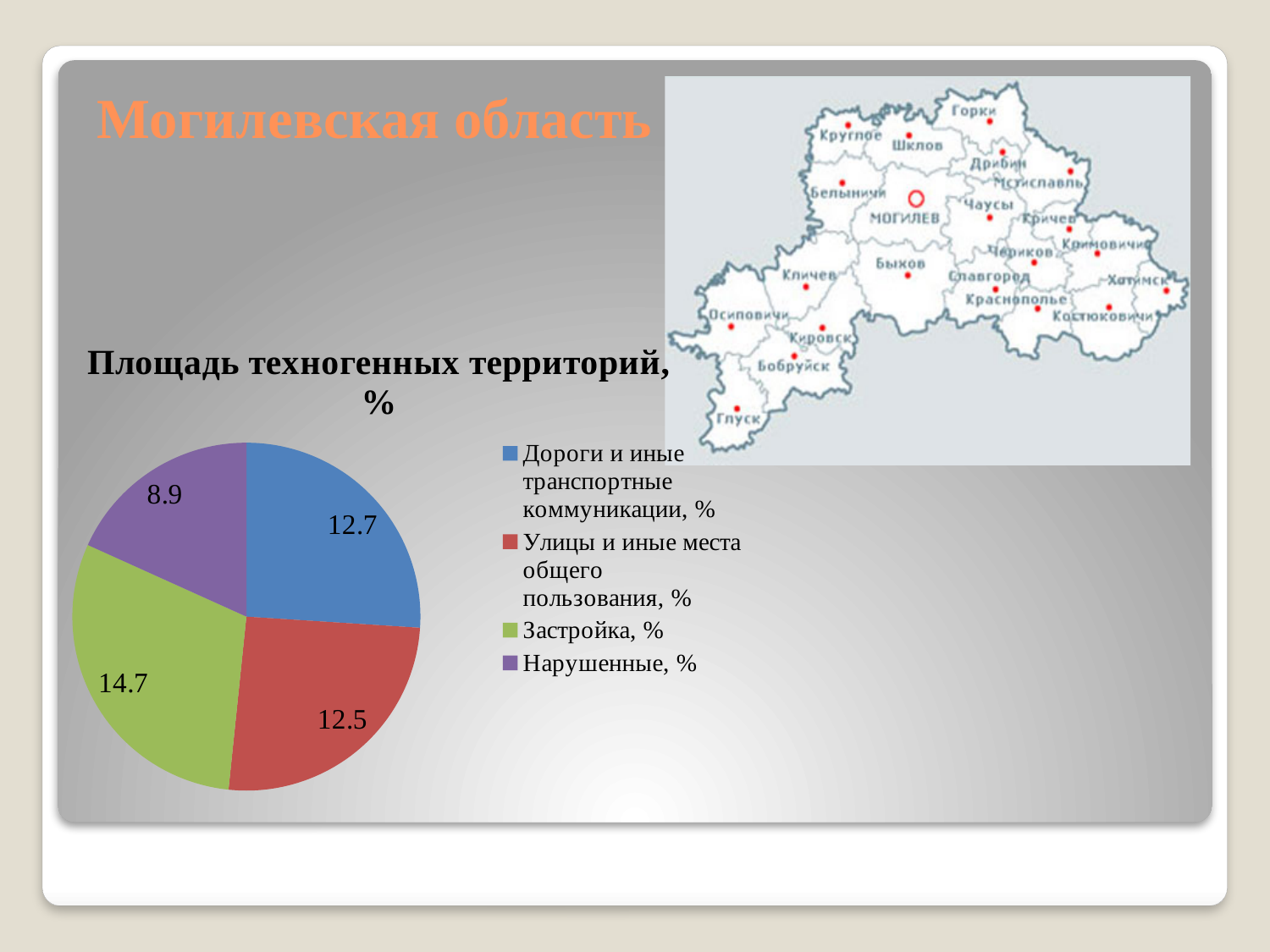
Which is larger: the value for Дороги и иные транспортные коммуникации, % or the value for Улицы и иные места общего пользования, %? Дороги и иные транспортные коммуникации, % What is the value for Улицы и иные места общего пользования, %? 12.5 Which category has the smallest slice of the pie? Нарушенные, % How many categories does the pie chart show? 4 Which category has the largest slice of the pie? Застройка, % What is the value for Застройка, %? 14.7 What type of chart is shown on the slide? Pie chart What is the value for Нарушенные, %? 8.9 What is the difference between the values for Застройка, % and Нарушенные, %? 5.8 What colour is the slice for Нарушенные, %? Purple What is the value for Дороги и иные транспортные коммуникации, %? 12.7 What is the title of the chart? Площадь техногенных территорий, %